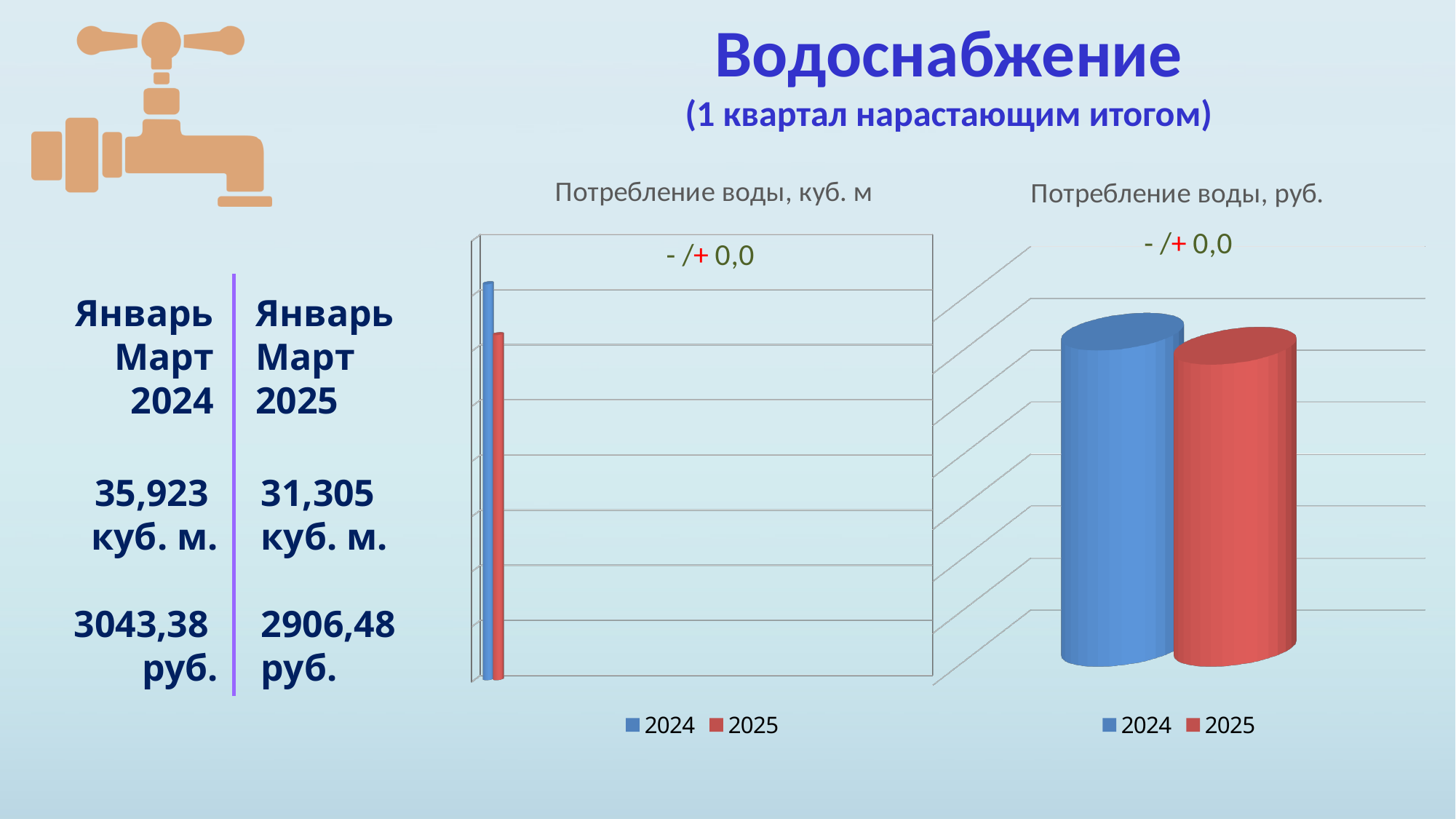
In the chart "Потребление воды, руб.", what colour is the bar for the 2025 series? red In the chart "Потребление воды, куб. м", which series has the highest bar? 2024 What is the title of the right chart on the slide? Потребление воды, руб. What kind of chart is the left chart titled "Потребление воды, куб. м"? bar chart According to the slide, what is the water consumption in cubic metres for January–March 2025 shown in the chart "Потребление воды, куб. м"? 31,305 куб. м. How many bars are plotted in the chart "Потребление воды, руб."? 2 In the chart "Потребление воды, куб. м", how many series does the legend list? 2 What kind of chart is the right chart titled "Потребление воды, руб."? bar chart In the chart "Потребление воды, руб.", how many series does the legend list? 2 In the chart "Потребление воды, руб.", which series has the lowest bar? 2025 In the chart "Потребление воды, куб. м", which series has the taller bar, 2024 or 2025? 2024 In the chart "Потребление воды, руб.", which series has the taller bar, 2024 or 2025? 2024